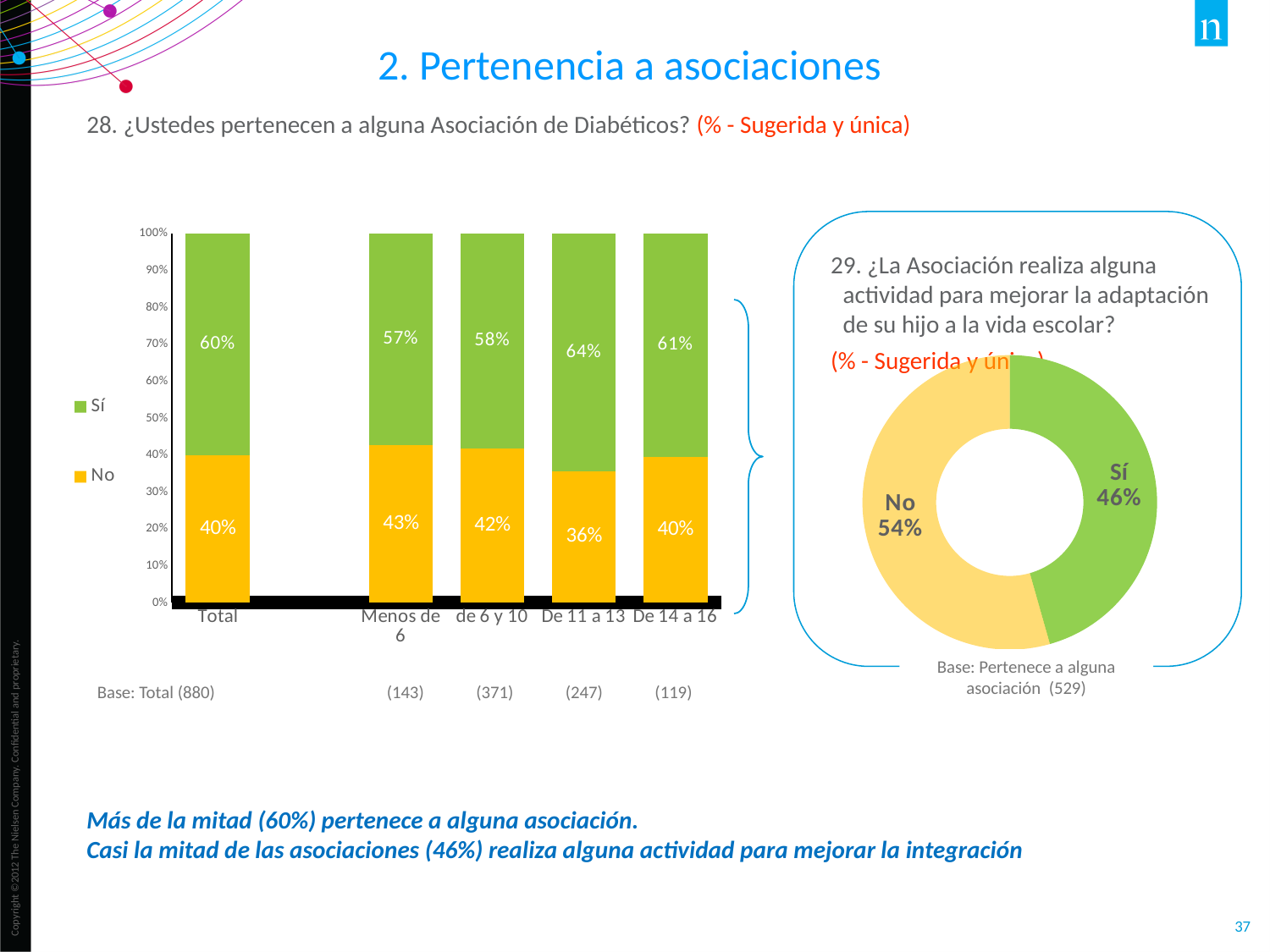
In the stacked bar chart on the left, what is the 'Sí' value for the 'Total' category? 60% In the stacked bar chart on the left, what is the 'Sí' value for 'De 11 a 13'? 64% How many categories are shown on the x axis of the stacked bar chart on the left? 5 In the donut chart on the right, which slice is larger, 'Sí' or 'No'? No What type of chart is the chart on the right of the slide? Donut chart In the stacked bar chart on the left, which category has the highest 'Sí' value? De 11 a 13 In the donut chart on the right, what share does 'Sí' have? 46% In the stacked bar chart on the left, is the 'No' value larger for 'de 6 y 10' or for 'De 11 a 13'? de 6 y 10 In the stacked bar chart on the left, what is the 'No' value for 'Menos de 6'? 43% How many series does the legend of the stacked bar chart on the left list? 2 In the stacked bar chart on the left, what is the difference between the 'Sí' values for 'De 14 a 16' and 'Menos de 6'? 4% In the stacked bar chart on the left, which category has the lowest 'No' value? De 11 a 13